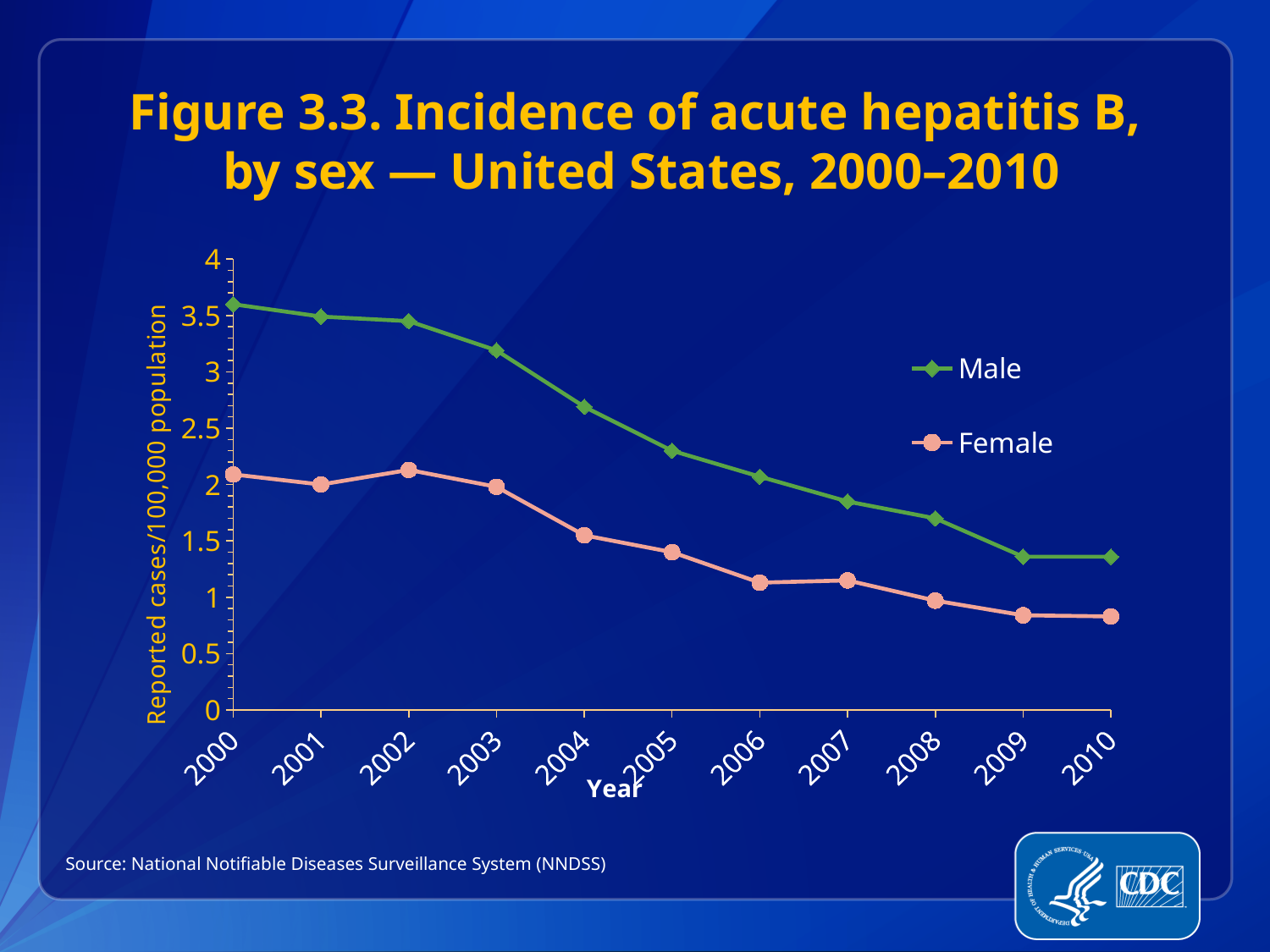
What is the label of the y axis? Reported cases/100,000 population Is the Male value for 2003 greater or less than 3? greater Is the Female value for 2010 greater or less than 1? less Is the Male value for 2007 greater or less than 2? less How many years are plotted along the x axis? 11 In 2005, which series has the higher incidence, Male or Female? Male What kind of chart is shown on the slide? line chart How many series does the legend list? 2 In which year is the Male incidence highest? 2000 Do the Male values generally rise or fall from 2000 to 2010? fall